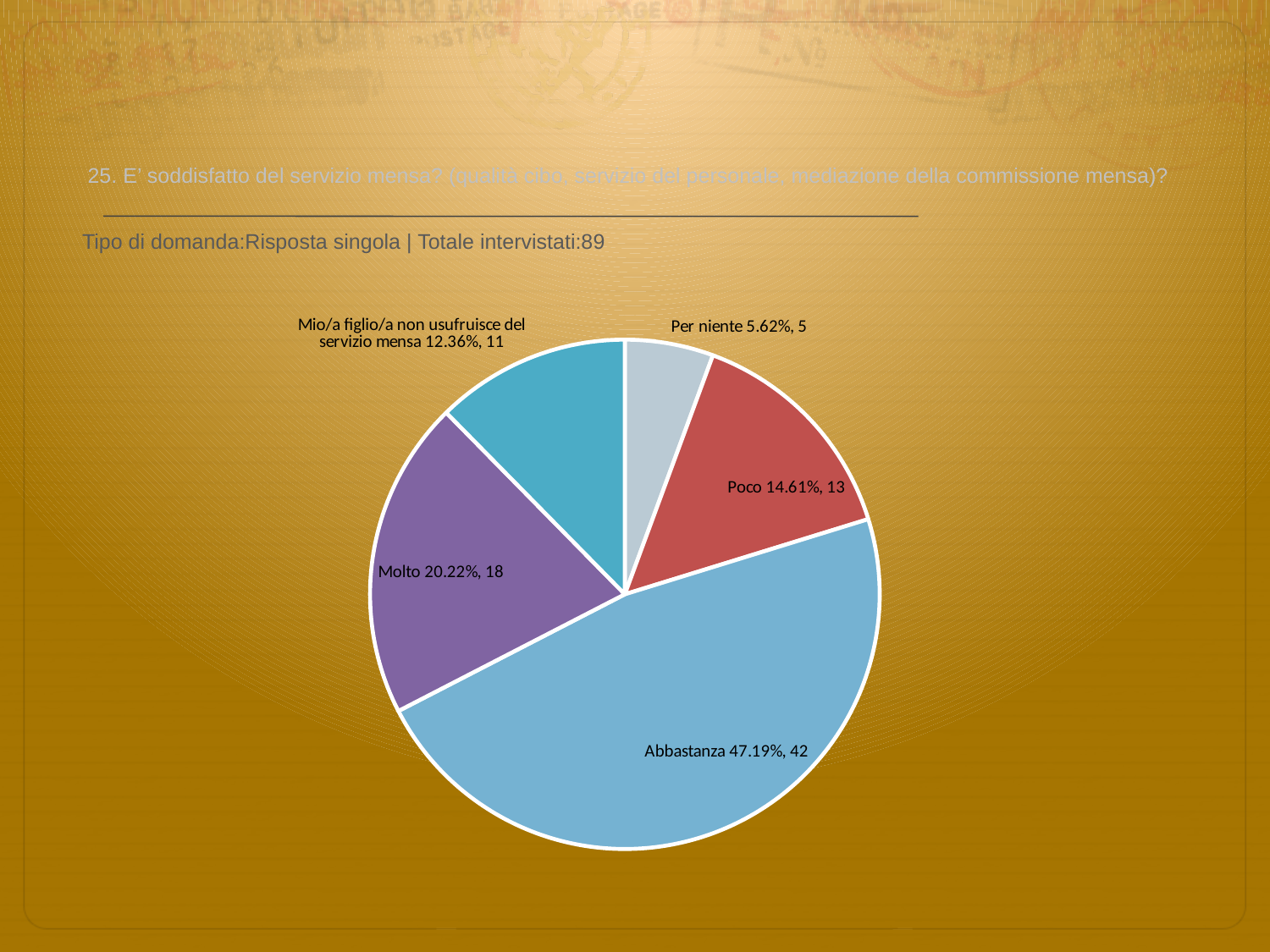
What kind of chart is shown on the slide? pie chart Which category has the smallest slice? Per niente Which has more respondents, 'Poco' or 'Mio/a figlio/a non usufruisce del servizio mensa'? Poco How many slices does the pie chart have? 5 What percentage share does the 'Per niente' slice have? 5.62% What colour is the 'Molto' slice? purple What is the total number of respondents stated on the slide? 89 What is the difference in respondent count between 'Abbastanza' and 'Molto'? 24 How many respondents answered 'Poco'? 13 What percentage share does the 'Abbastanza' slice have? 47.19% Which category has the largest slice? Abbastanza How many respondents answered 'Molto'? 18